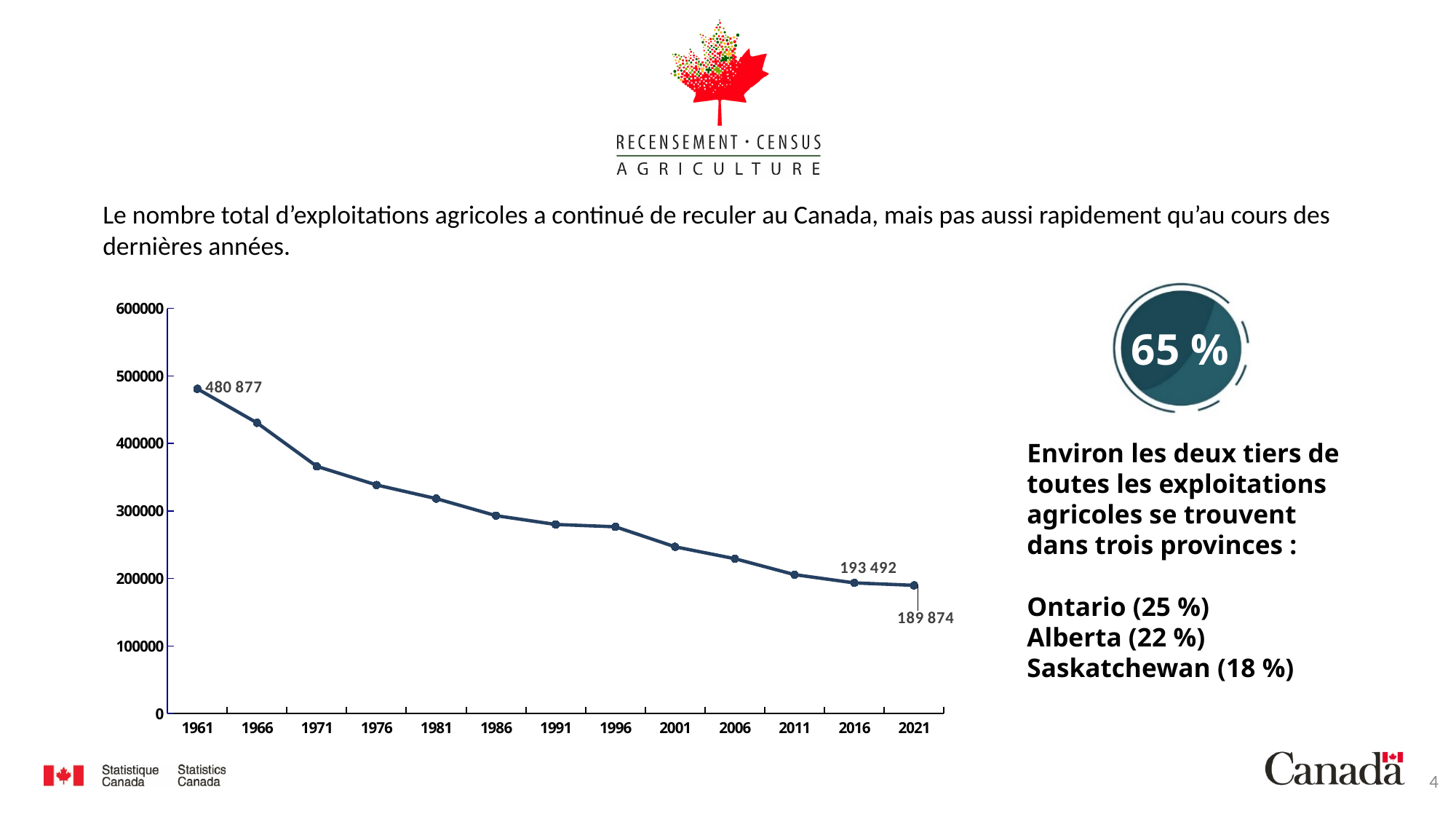
Is the value for 2001 greater or less than 300000? less Which is larger, the value for 2016 or the value for 2021? 2016 How many years are plotted on the x axis? 13 What is the value for 2021? 189 874 What is the value for 1961? 480 877 Which year has the highest value? 1961 What is the difference between the values for 1961 and 2021? 291 003 Is the value for 1971 greater or less than 400000? less What kind of chart is shown on the slide? line chart Which year has the lowest value? 2021 What is the value for 2016? 193 492 What is the difference between the values for 2016 and 2021? 3 618